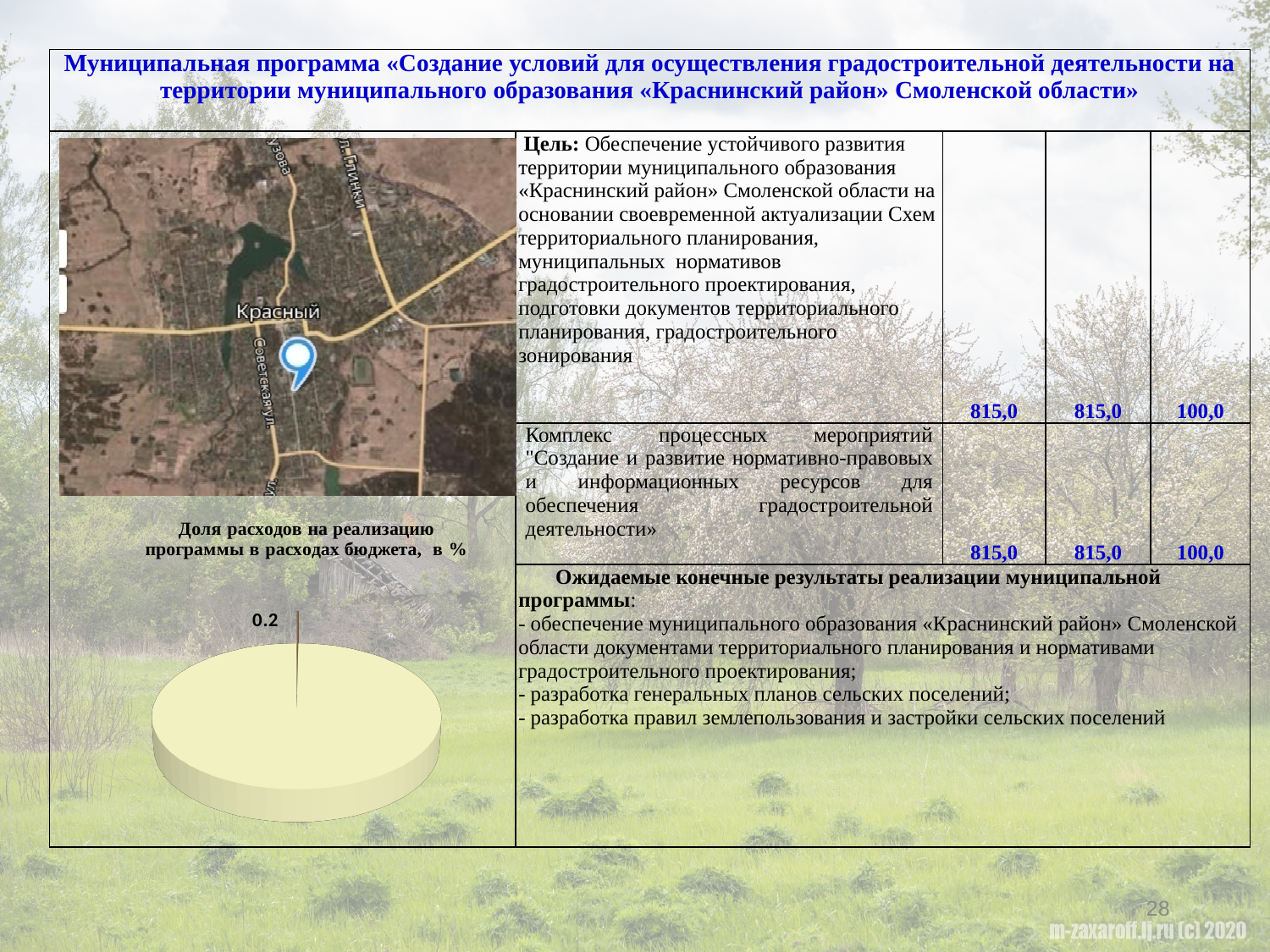
What is the title of the pie chart? Доля расходов на реализацию программы в расходах бюджета, в % What kind of chart is shown on the slide? pie chart What value is printed as the data label on the pie chart? 0.2 How many data labels are printed on the pie chart? 1 Is the labelled value on the pie chart greater or less than 1? less In what unit does the pie chart title say the share is expressed? %